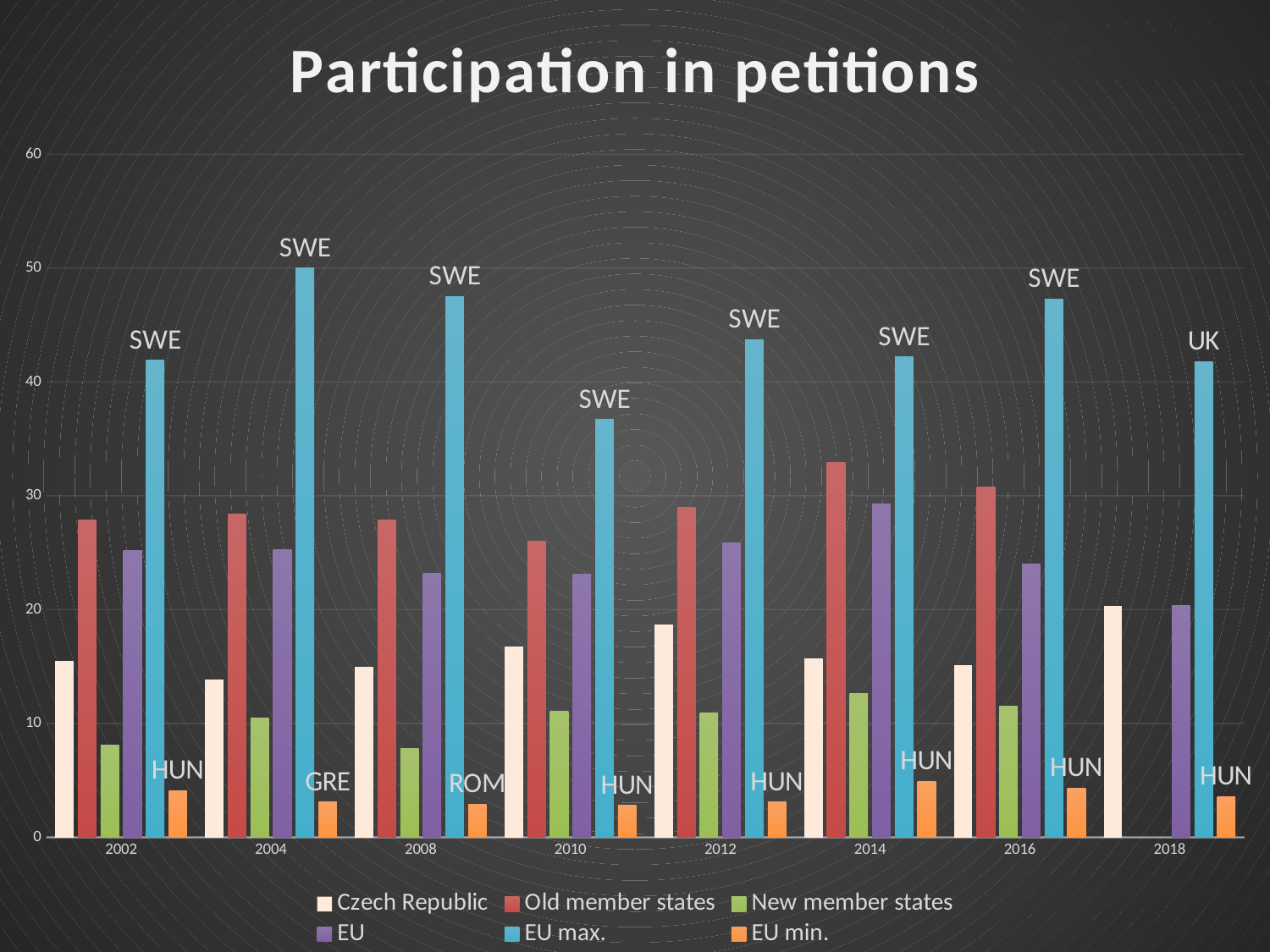
Does the Czech Republic value rise or fall from 2016 to 2018? rise In which year is the EU max. value the lowest? 2010 Which country is labelled as the EU min. in 2008? ROM Is the EU max. value for 2004 greater or less than 40? greater Is the Czech Republic value for 2018 greater or less than 10? greater Which country is labelled as the EU min. in 2004? GRE How many years are shown on the x axis? 8 What is the title of the chart? Participation in petitions Which is larger, the Old member states value for 2014 or for 2002? 2014 Which country is labelled as the EU max. in 2018? UK What kind of chart is shown on the slide? bar chart How many series does the legend list? 6